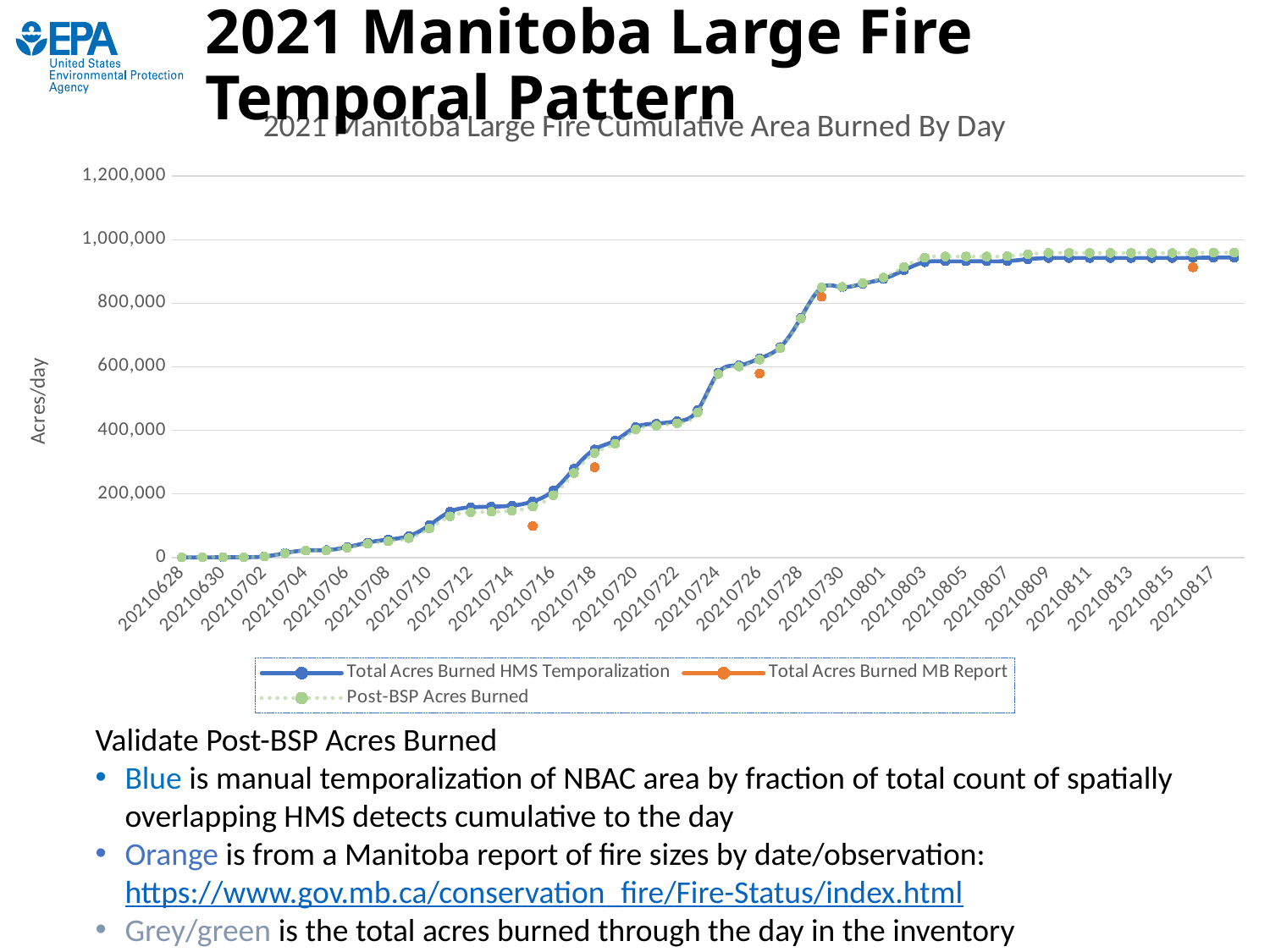
What kind of chart is shown on the slide? Line chart How many series does the legend list? 3 Is the value for Total Acres Burned MB Report at 20210715 greater or less than 200,000? less What is the label on the vertical axis? Acres/day Is the value for Total Acres Burned HMS Temporalization at 20210710 greater or less than 200,000? less Is the value for Total Acres Burned HMS Temporalization at 20210724 greater or less than 400,000? greater At 20210715, which is larger: Total Acres Burned HMS Temporalization or Total Acres Burned MB Report? Total Acres Burned HMS Temporalization Does the Total Acres Burned HMS Temporalization series rise or fall from 20210628 to 20210817? Rise What is the title of the chart? 2021 Manitoba Large Fire Cumulative Area Burned By Day